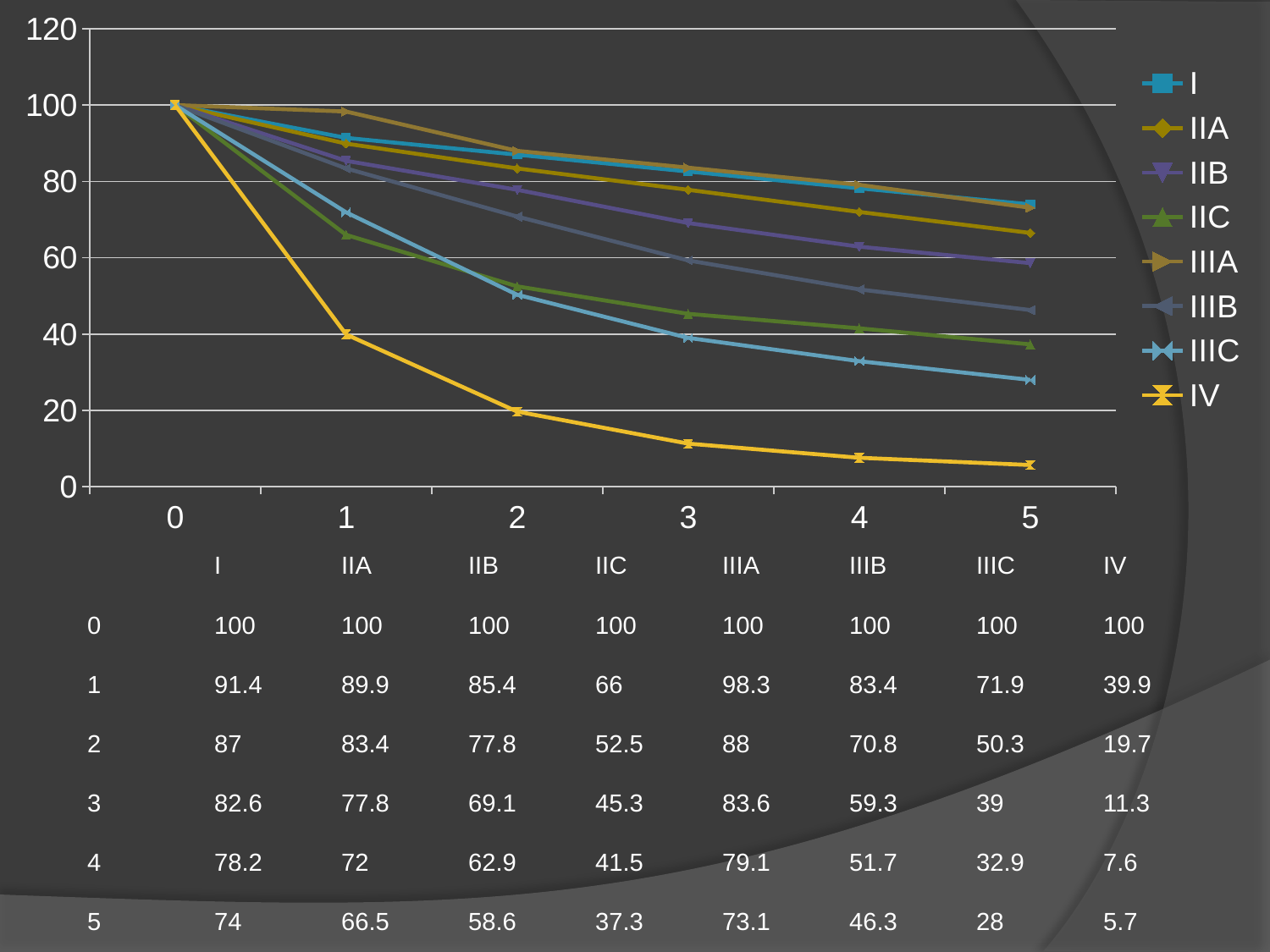
What is the value of series IV at x = 5? 5.7 What is the value of series IIIA at x = 1? 98.3 Which series has the lowest value at x = 5? IV What is the difference between series I and series IIA at x = 5? 7.5 Is the value of series IIIB at x = 4 greater or less than 60? less How many series does the legend list? 8 What is the value of series IIC at x = 3? 45.3 Do the values of series IIIC rise or fall as x increases from 0 to 5? fall What kind of chart is shown on the slide? line chart Which series has the highest value at x = 1? IIIA How many x-axis points are plotted for each series? 6 Which is larger at x = 2: series IIB or series IIIB? IIB